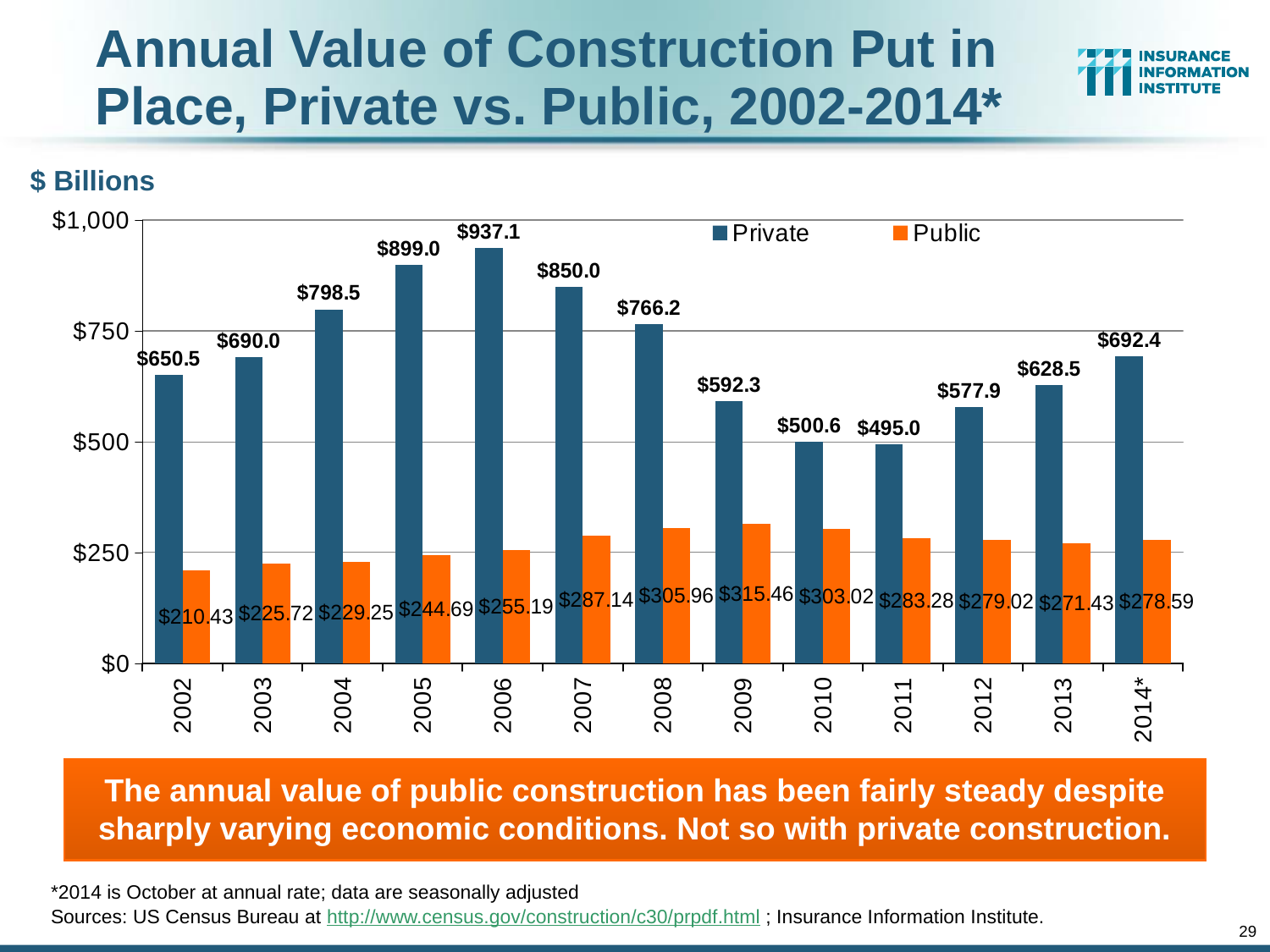
Which year has the highest value for private construction? 2006 What is the value of private construction put in place in 2014*? $692.4 What kind of chart is shown on the slide? Bar chart What is the value of public construction put in place in 2009? $315.46 Which year has the lowest value for private construction? 2011 What is the value of private construction put in place in 2006? $937.1 What is the difference between the private construction values in 2006 and 2011? $442.1 How many series does the legend list? 2 Which year has the lowest value for public construction? 2002 Which is larger, the private construction value in 2003 or in 2013? 2003 How many years are shown on the x axis? 13 Did the value of private construction rise or fall from 2006 to 2011? Fall